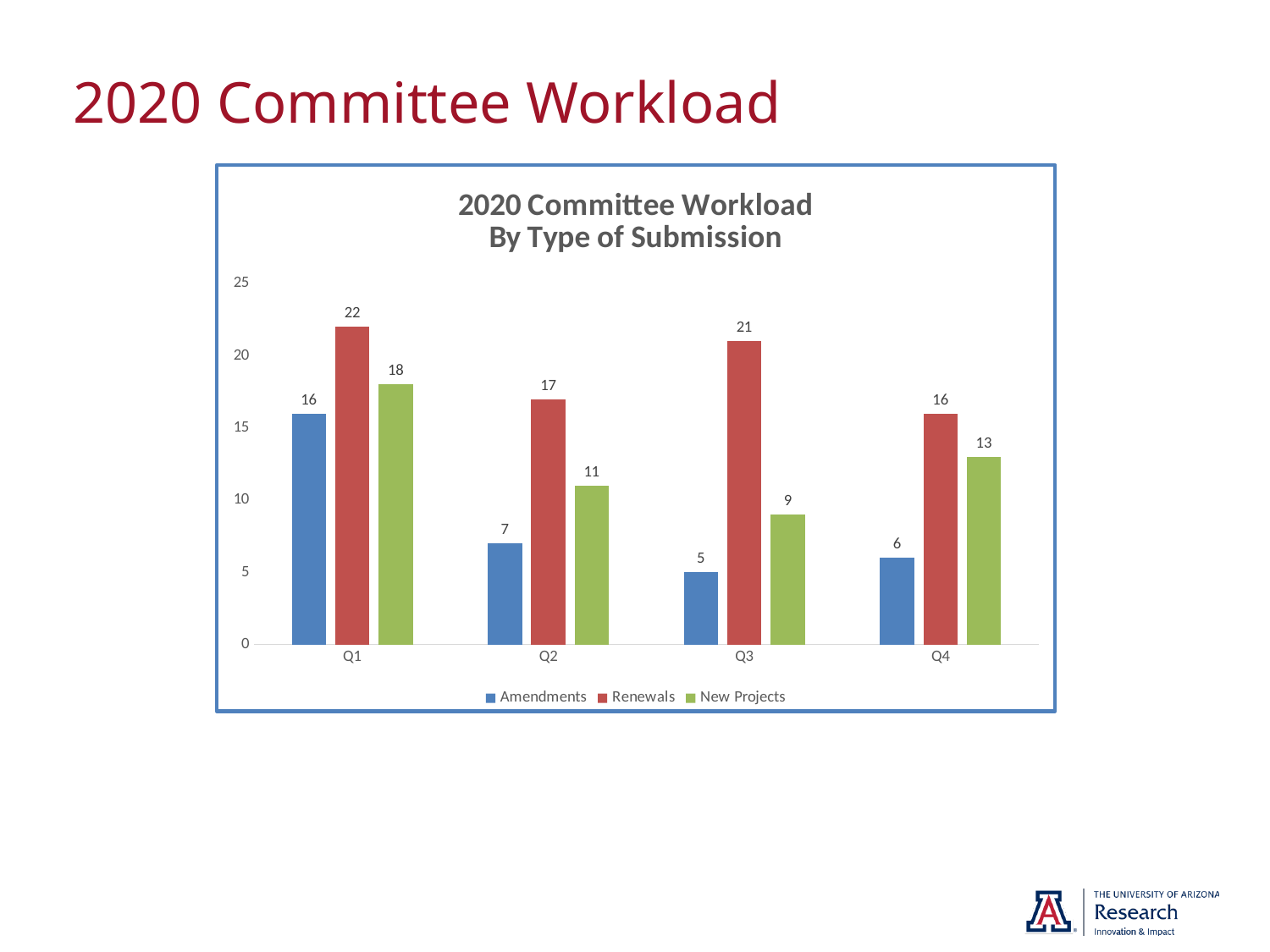
How many quarters are shown on the x axis? 4 Does the Amendments value rise or fall from Q1 to Q2? Fall What is the value for New Projects in Q4? 13 What is the value for Amendments in Q3? 5 What colour are the Renewals bars? Red In which quarter is the New Projects value lowest? Q3 What is the value for Renewals in Q1? 22 In which quarter is the Amendments value highest? Q1 How many series does the legend list? 3 What is the difference between Renewals and Amendments in Q3? 16 What kind of chart is shown on the slide? Bar chart Which is larger in Q2: Renewals or New Projects? Renewals